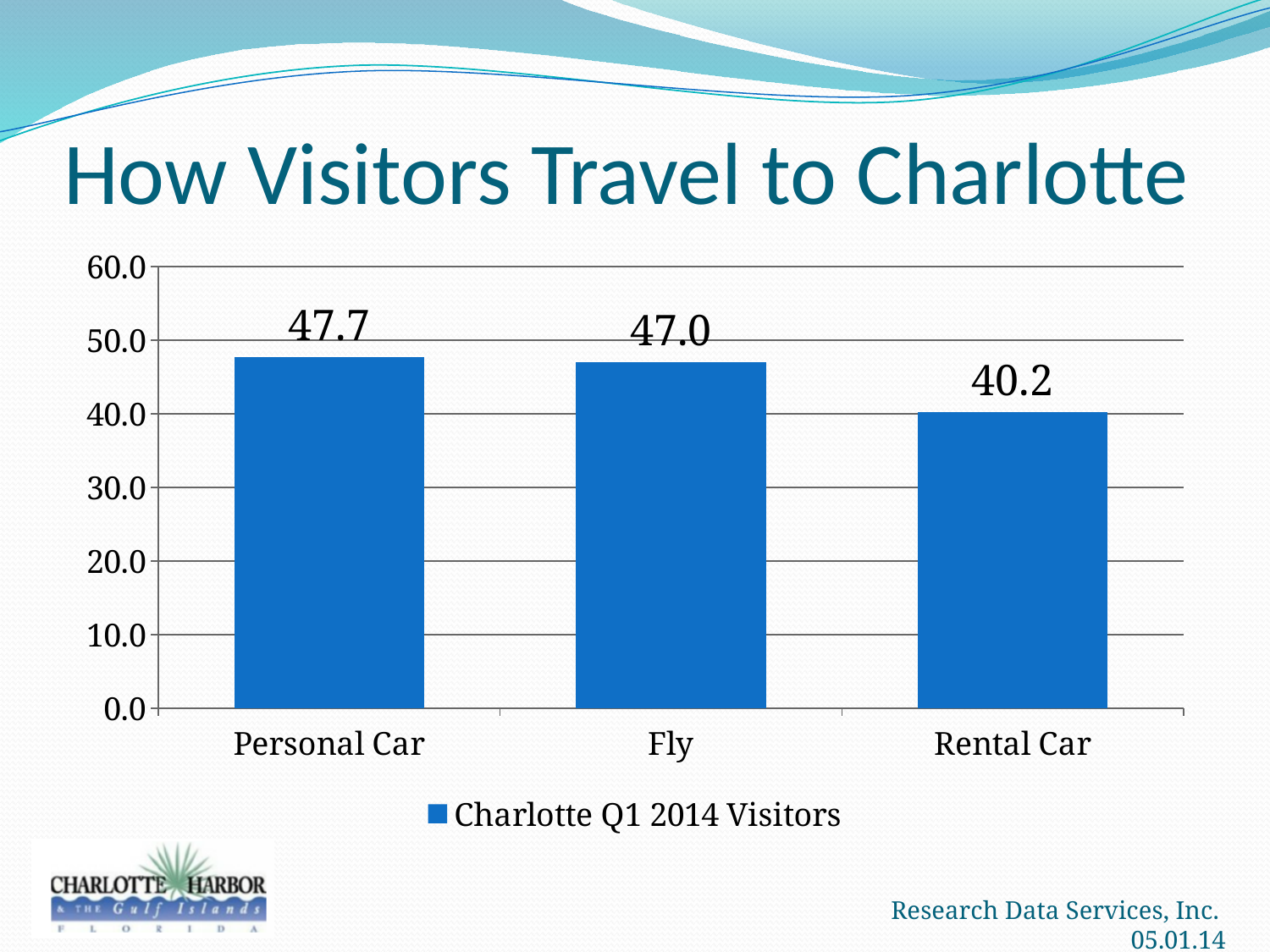
How many categories are shown on the x axis? 3 What is the value for Personal Car? 47.7 What is the difference between the values for Personal Car and Rental Car? 7.5 What is the title of the chart? How Visitors Travel to Charlotte Is the value for Rental Car greater or less than 50.0? less What kind of chart is shown on the slide? bar chart How many series does the legend list? 1 What is the difference between the values for Fly and Rental Car? 6.8 What is the value for Rental Car? 40.2 Which is larger, the value for Fly or the value for Rental Car? Fly Which category has the lowest value? Rental Car What is the value for Fly? 47.0